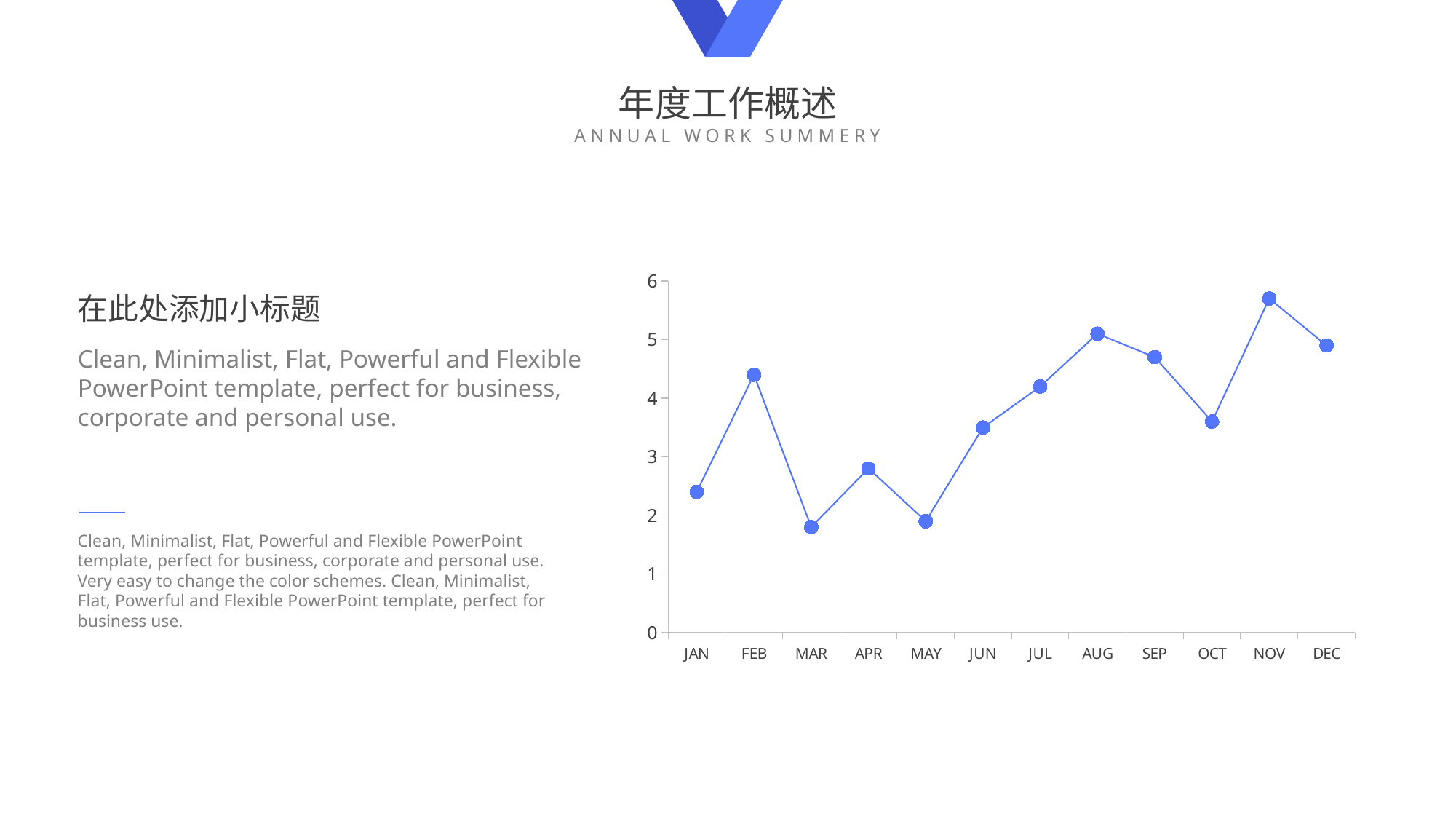
How many months are plotted on the x axis of the chart? 12 Do the values rise or fall from AUG to OCT? fall Is the value for MAR greater or less than 2? less Which is larger, the value for FEB or the value for MAR? FEB What kind of chart is shown on the slide? line chart Is the value for FEB greater or less than 4? greater Is the value for JAN greater or less than 3? less Which month has the highest value on the chart? NOV Which is larger, the value for JAN or the value for APR? APR Do the values rise or fall from MAY to AUG? rise